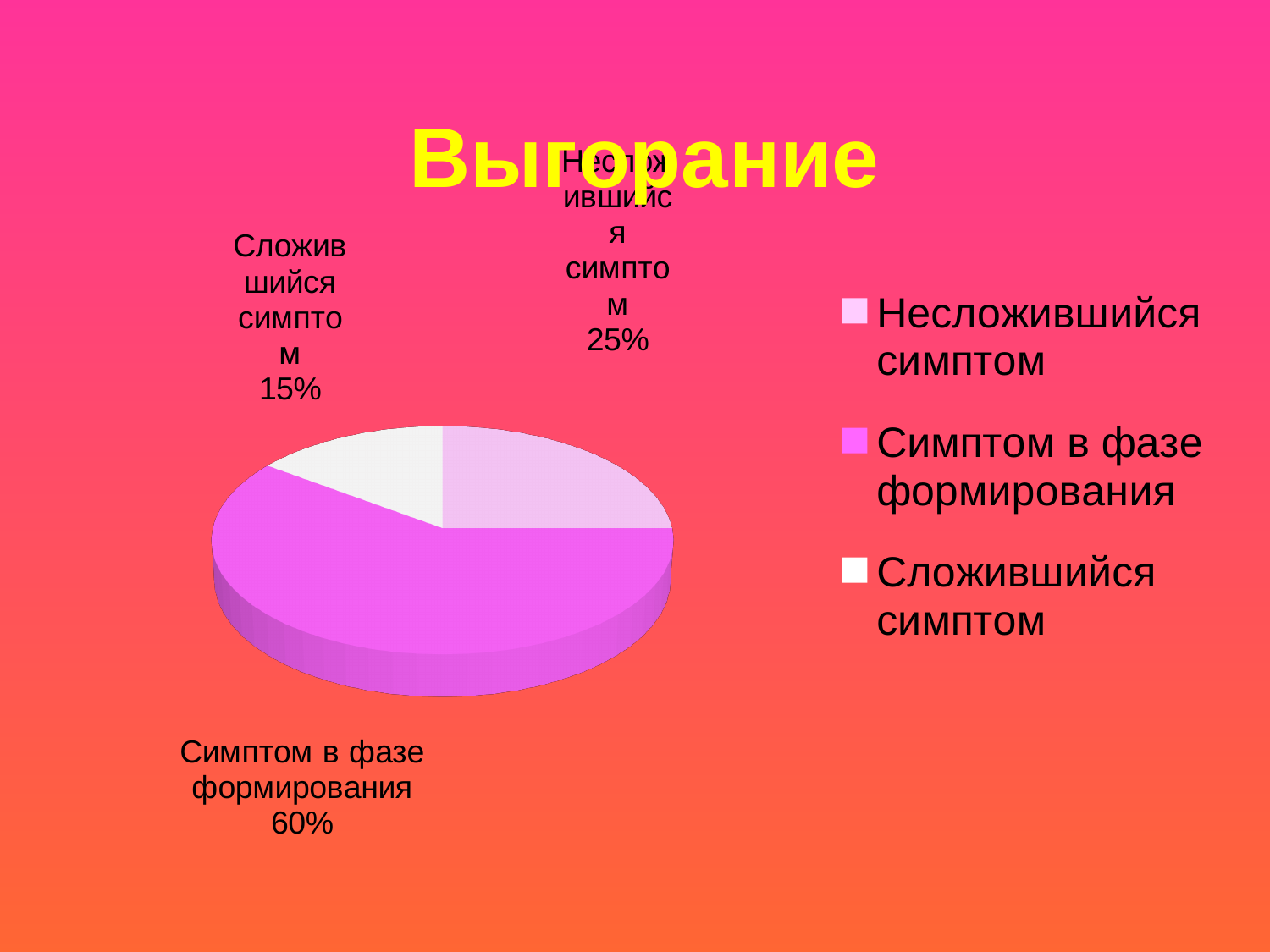
What kind of chart is shown on the slide? Pie chart How many slices does the pie chart have? 3 Which category has the smallest slice of the pie? Сложившийся симптом What colour is the slice for "Сложившийся симптом"? White What is the difference in percentage points between "Симптом в фазе формирования" and "Несложившийся симптом"? 35 What share of the pie is "Симптом в фазе формирования"? 60% What share of the pie is "Сложившийся симптом"? 15% Which category has the largest slice of the pie? Симптом в фазе формирования What is the title of the chart? Выгорание Which is larger: the share for "Несложившийся симптом" or the share for "Сложившийся симптом"? Несложившийся симптом What share of the pie is "Несложившийся симптом"? 25% How many entries does the legend list? 3